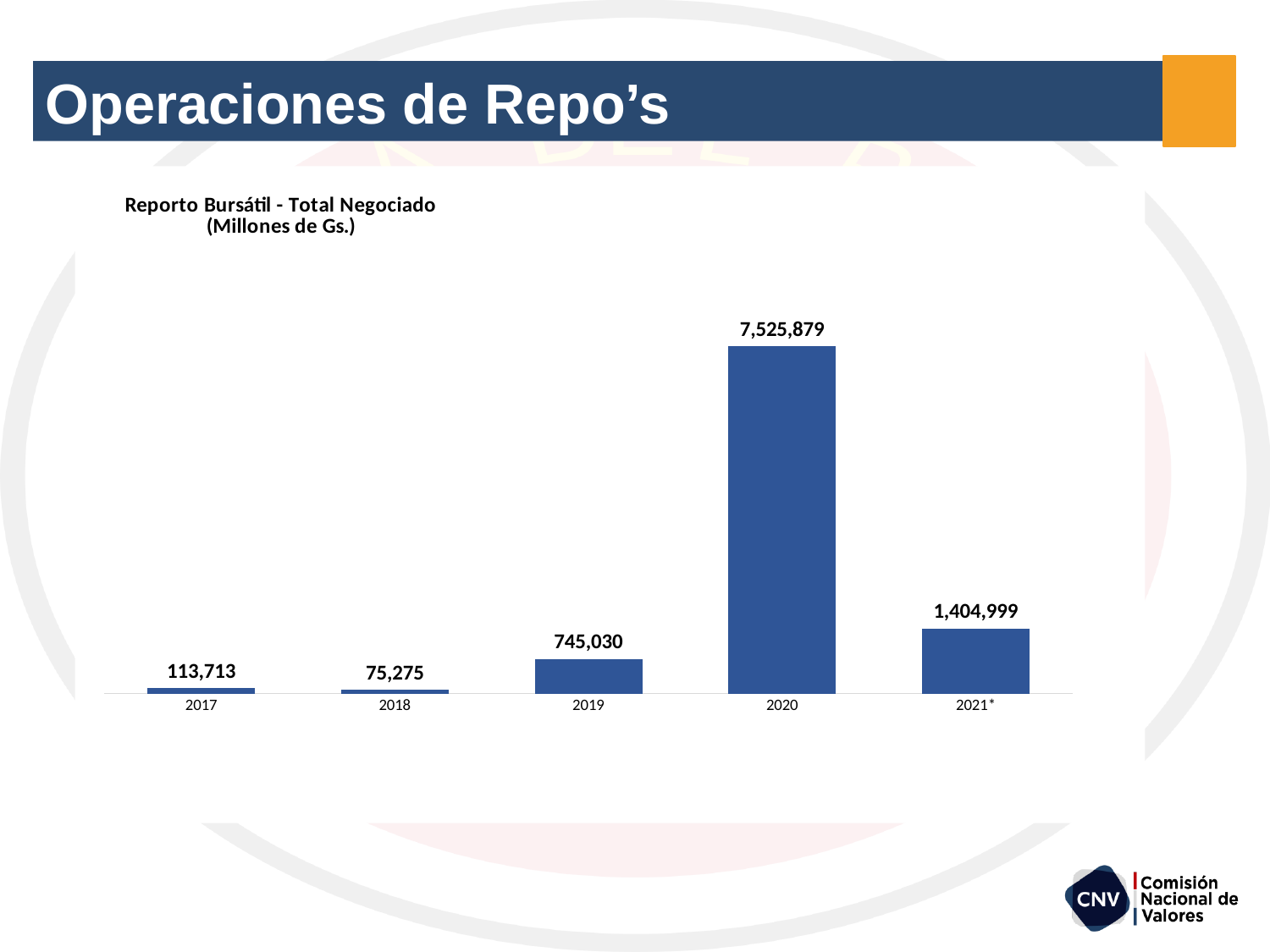
What is the value for 2020 in the chart? 7,525,879 Which year has the highest value in the chart? 2020 What unit is stated in the chart title? Millones de Gs. What kind of chart is shown on the slide? Bar chart Which year has the lowest value in the chart? 2018 What is the value for 2018 in the chart? 75,275 How many years are shown on the x axis of the chart? 5 What is the value for 2017 in the chart? 113,713 What is the value for 2021* in the chart? 1,404,999 What is the difference between the values for 2020 and 2021*? 6,120,880 What is the difference between the values for 2017 and 2018? 38,438 Which is larger, the value for 2019 or the value for 2021*? 2021*